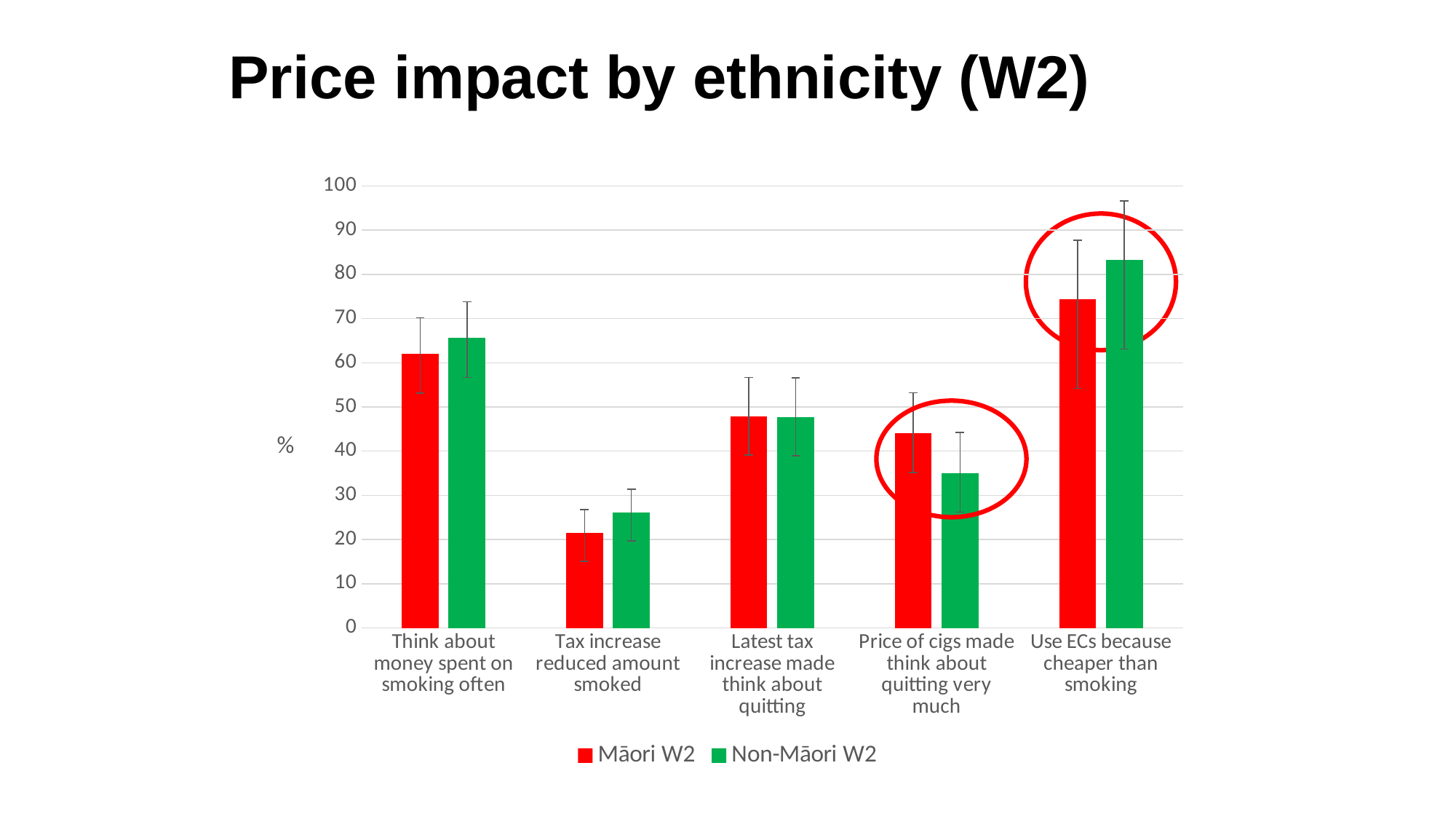
For 'Price of cigs made think about quitting very much', which series has the larger value, Māori W2 or Non-Māori W2? Māori W2 Is the Non-Māori W2 value for 'Price of cigs made think about quitting very much' greater or less than 40? less How many series does the legend list? 2 For 'Use ECs because cheaper than smoking', which series has the larger value, Māori W2 or Non-Māori W2? Non-Māori W2 Is the Māori W2 value for 'Tax increase reduced amount smoked' greater or less than 30? less What kind of chart is shown on the slide? bar chart What is the title of the slide? Price impact by ethnicity (W2) Which category has the lowest value for Non-Māori W2? Tax increase reduced amount smoked How many categories are shown on the x axis? 5 Is the Māori W2 value for 'Think about money spent on smoking often' greater or less than 50? greater Which category has the lowest value for Māori W2? Tax increase reduced amount smoked Which category has the highest value for Māori W2? Use ECs because cheaper than smoking